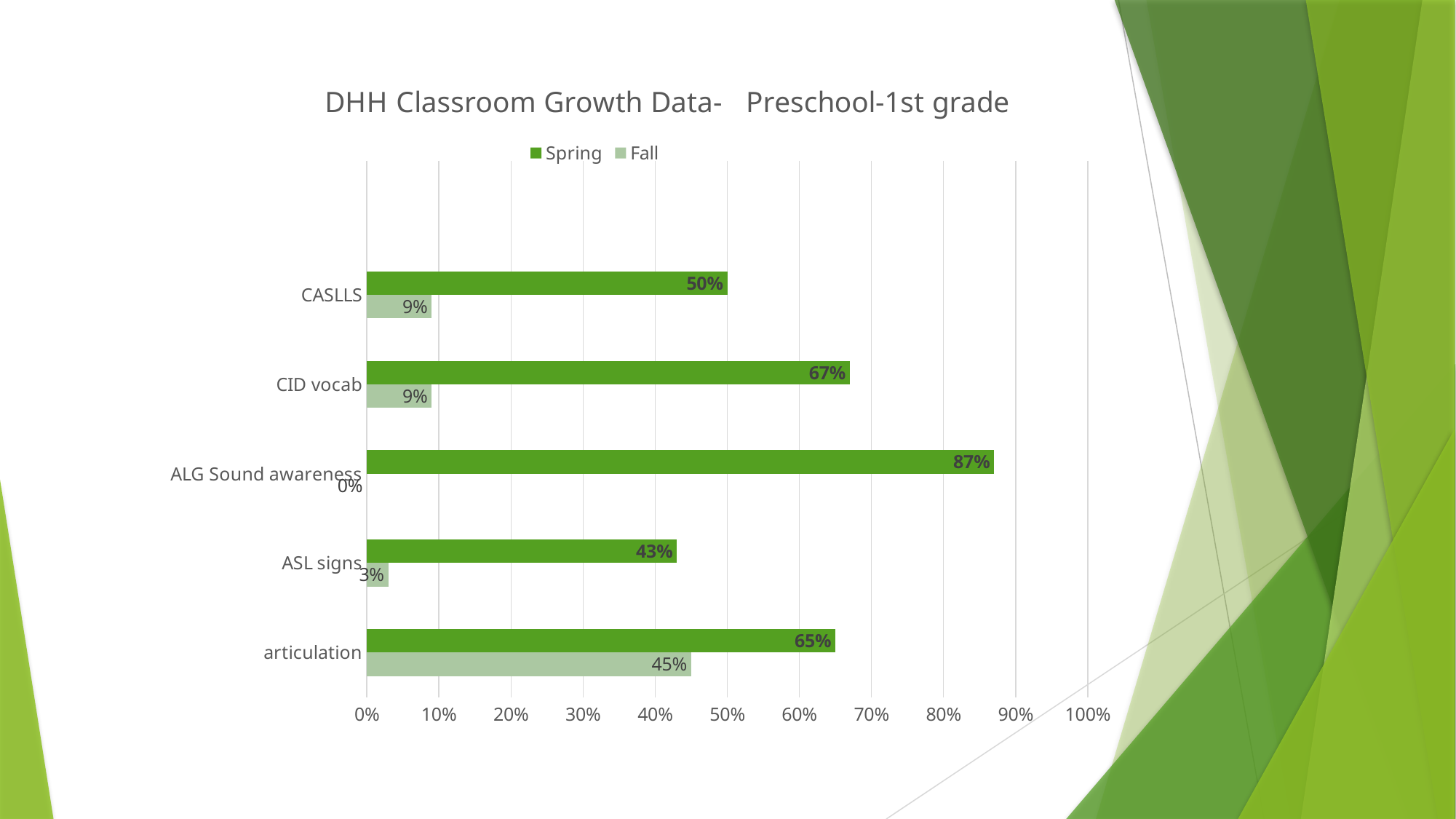
What is the title of the chart? DHH Classroom Growth Data- Preschool-1st grade How many categories are shown on the chart? 5 Which category has the highest Spring value? ALG Sound awareness How many series does the legend list? 2 What is the Fall value for ASL signs? 3% What is the Fall value for articulation? 45% What is the difference between the Spring and Fall values for articulation? 20% Which is larger, the Spring value for CASLLS or the Spring value for CID vocab? CID vocab What kind of chart is shown on the slide? Bar chart What is the Spring value for ALG Sound awareness? 87% What is the Spring value for CID vocab? 67% Which category has the lowest Fall value? ALG Sound awareness